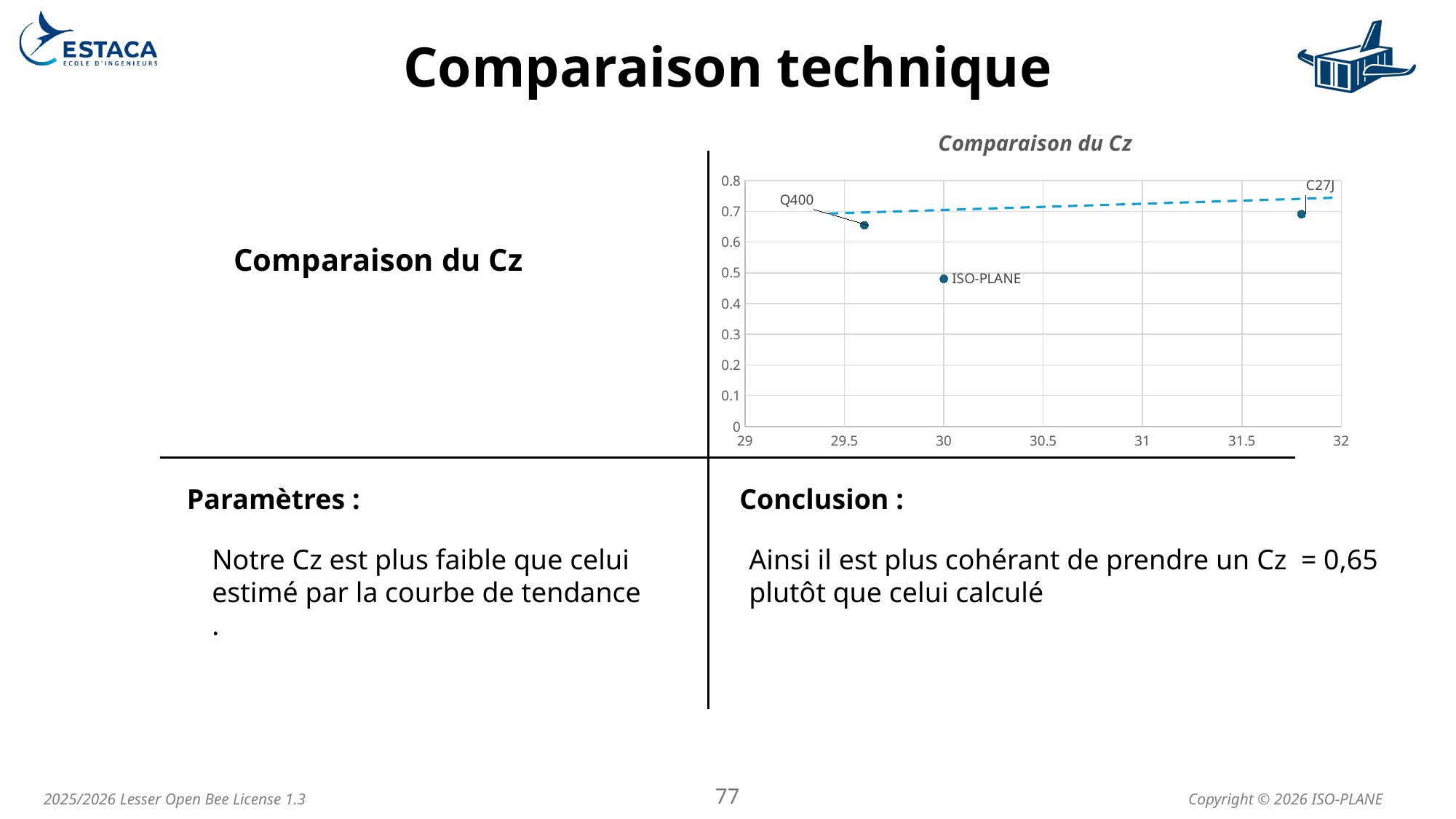
Is the Cz value for Q400 greater or less than 0.6? greater What is the title of the chart? Comparaison du Cz Which has a higher Cz value, Q400 or ISO-PLANE? Q400 Does the dashed trend line rise or fall as the x-axis value increases? rises What kind of chart is shown on the slide? scatter chart Which labelled point has the lowest Cz value? ISO-PLANE How many labelled data points are plotted on the chart? 3 What is the x-axis value at which the ISO-PLANE point is plotted? 30 Is the Cz value for ISO-PLANE greater or less than 0.5? less Which labelled point has the highest Cz value? C27J Is the Cz value for Q400 greater or less than 0.7? less